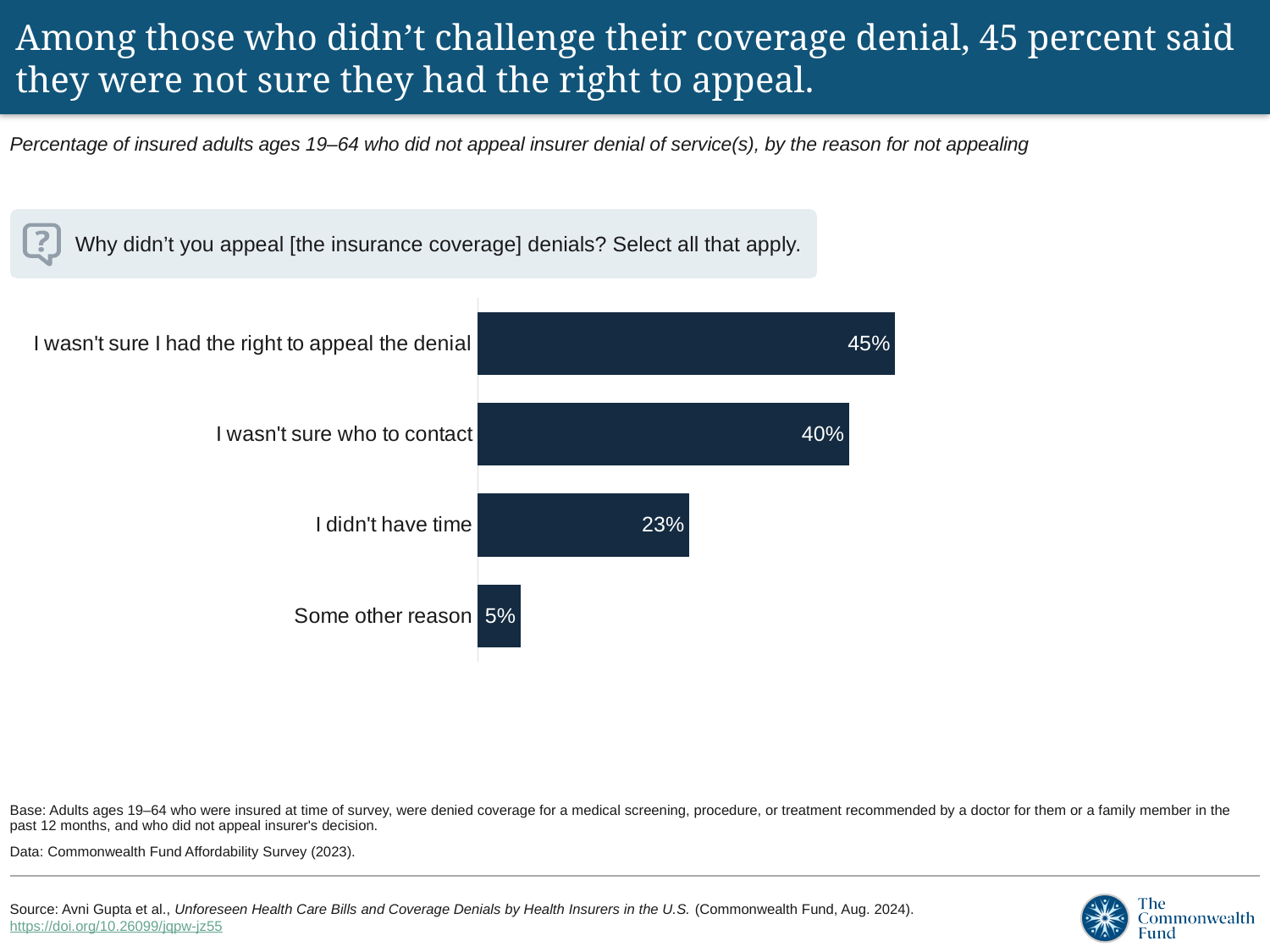
What is the difference in percentage points between 'I didn't have time' and 'Some other reason'? 18 percentage points What is the difference in percentage points between 'I wasn't sure I had the right to appeal the denial' and 'I wasn't sure who to contact'? 5 percentage points How many reasons for not appealing are shown in the chart? 4 What type of chart is shown on the slide? Bar chart Which reason for not appealing has the lowest percentage? Some other reason What percentage of respondents cited some other reason for not appealing? 5% Which is larger: the percentage for 'I didn't have time' or for 'I wasn't sure who to contact'? I wasn't sure who to contact Which reason for not appealing has the highest percentage? I wasn't sure I had the right to appeal the denial What survey question is shown above the chart? Why didn't you appeal [the insurance coverage] denials? Select all that apply. What percentage of respondents said they weren't sure they had the right to appeal the denial? 45% What percentage of respondents said they didn't have time? 23% What percentage of respondents said they weren't sure who to contact? 40%